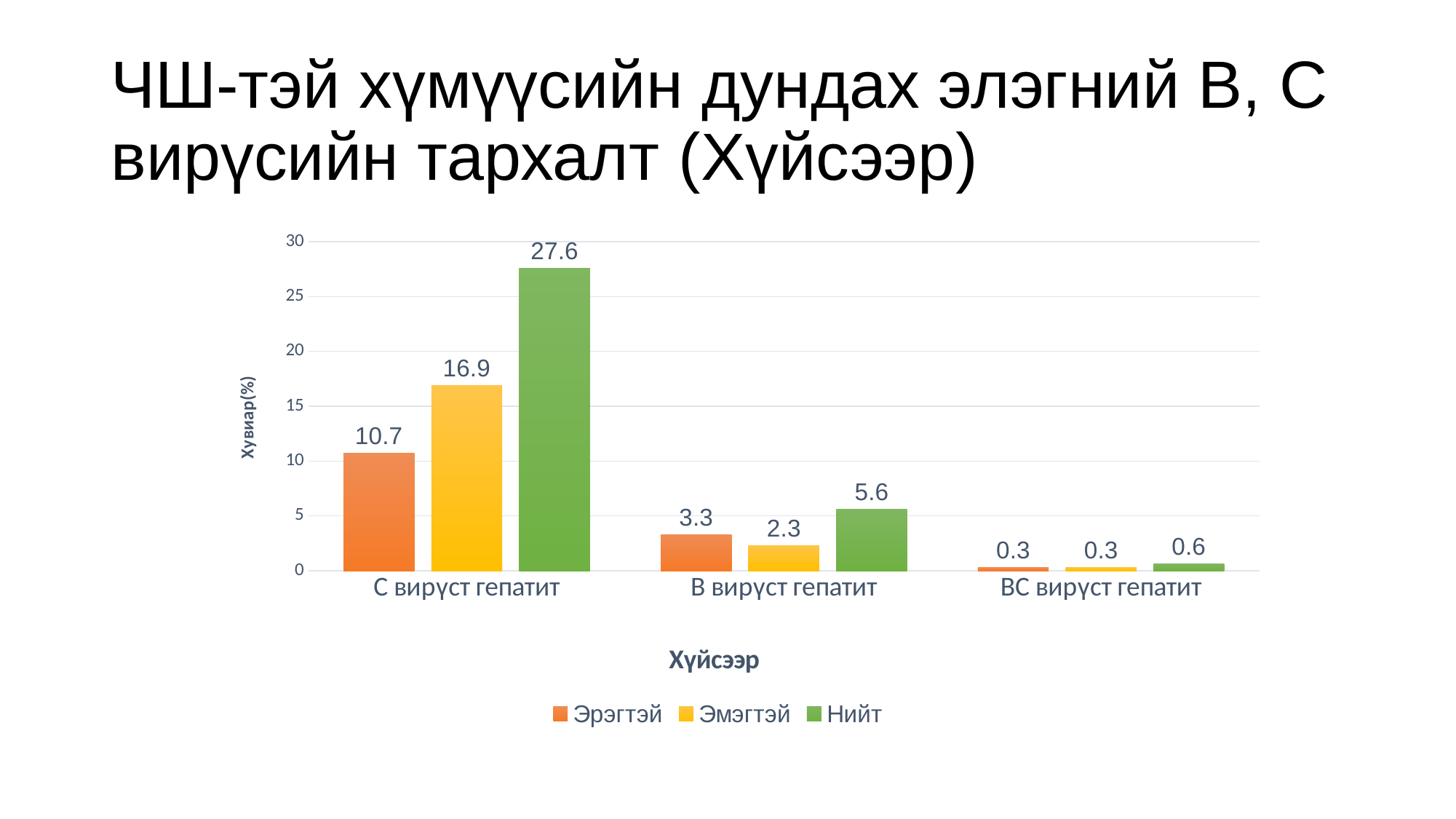
What is the difference between the Эмэгтэй and Эрэгтэй values in the С вирүст гепатит category? 6.2 What is the label of the y axis? Хувиар(%) Is the Нийт value for С вирүст гепатит greater or less than 25? greater How many categories are shown on the x axis? 3 Which category has the lowest Эмэгтэй value? ВС вирүст гепатит What is the value for Эмэгтэй in the В вирүст гепатит category? 2.3 How many series does the legend list? 3 What is the value for Эрэгтэй in the ВС вирүст гепатит category? 0.3 What is the value for Нийт in the С вирүст гепатит category? 27.6 What kind of chart is shown on the slide? bar chart Which category has the highest Нийт value? С вирүст гепатит In the В вирүст гепатит category, which is larger, Эрэгтэй or Эмэгтэй? Эрэгтэй